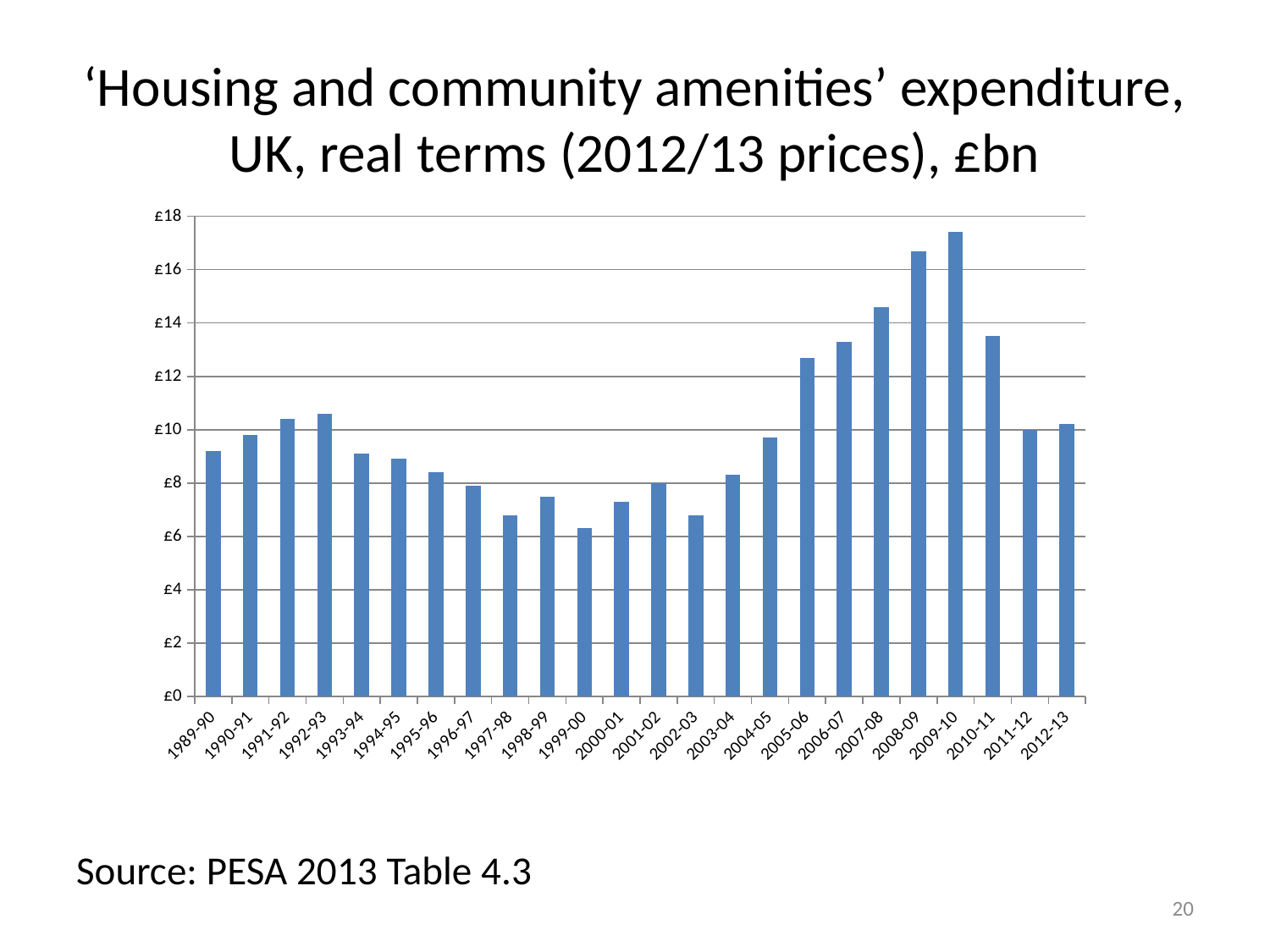
How many financial years are plotted on the chart? 24 What kind of chart is shown on the slide? Bar chart Is the value for 1999-00 greater or less than £8? less Is the value for 1989-90 greater or less than £10? less What is the title of the chart on the slide? 'Housing and community amenities' expenditure, UK, real terms (2012/13 prices), £bn Which year has the highest 'Housing and community amenities' expenditure? 2009-10 Which year has the lowest 'Housing and community amenities' expenditure? 1999-00 Which is larger, the expenditure in 1992-93 or in 2002-03? 1992-93 Which is larger, the expenditure in 2008-09 or in 2010-11? 2008-09 Is the value for 2009-10 greater or less than £16? greater Do the values rise or fall from 2005-06 to 2009-10? Rise